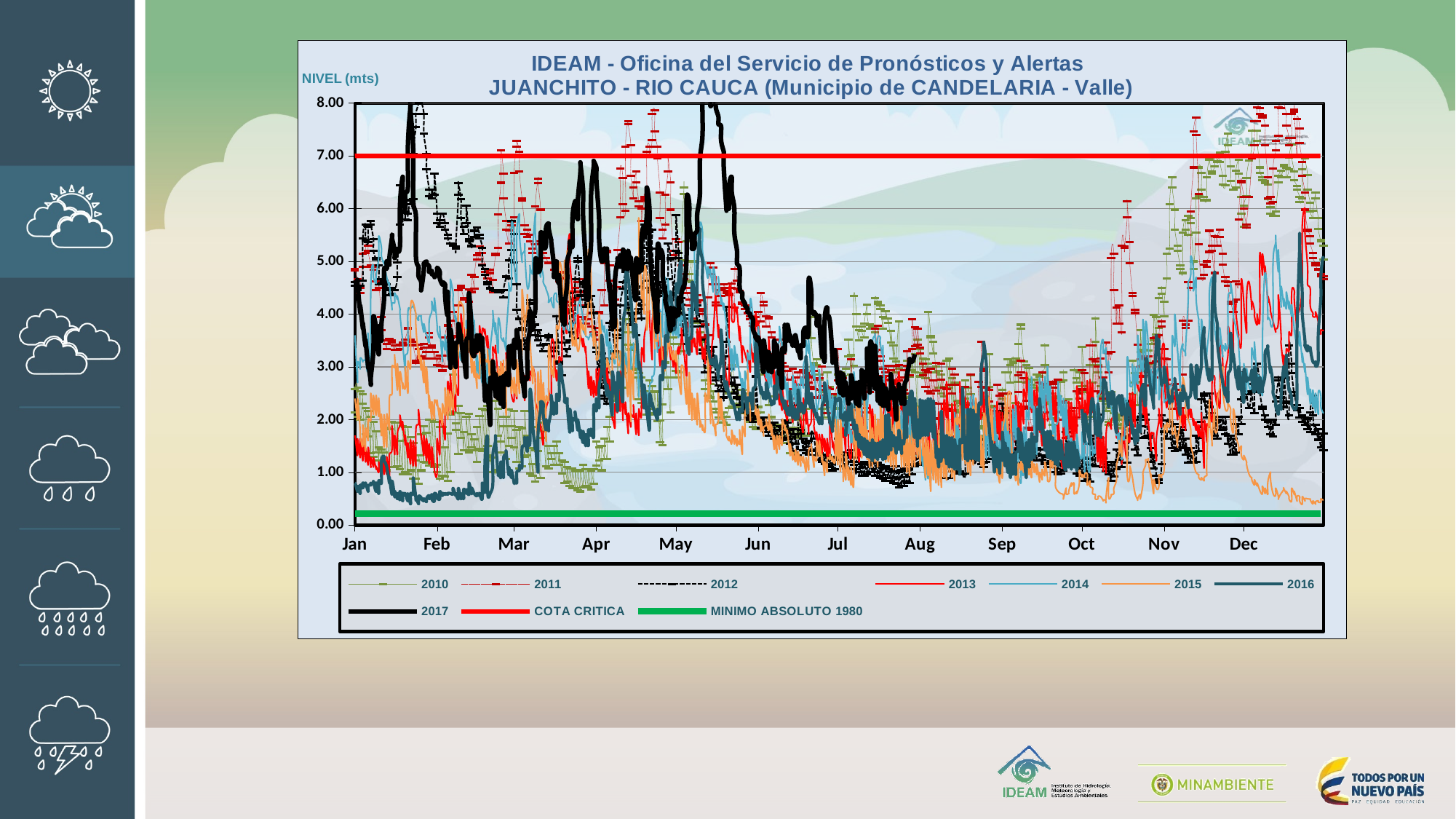
How many series does the legend list? 10 What is the highest value shown on the y axis? 8.00 How many months are labelled along the x axis? 12 Is the peak value of the 2017 series in May greater or less than 7.00? greater What kind of chart is shown on the slide? line chart Does the 2015 series rise or fall from October to December? fall What is the label of the y axis? NIVEL (mts) Is the MINIMO ABSOLUTO 1980 line greater or less than 1.00? less At what level is the COTA CRITICA line drawn? 7.00 Is the value of the 2015 series in December greater or less than 1.00? less What is the title of the chart (second line)? JUANCHITO - RIO CAUCA (Municipio de CANDELARIA - Valle)